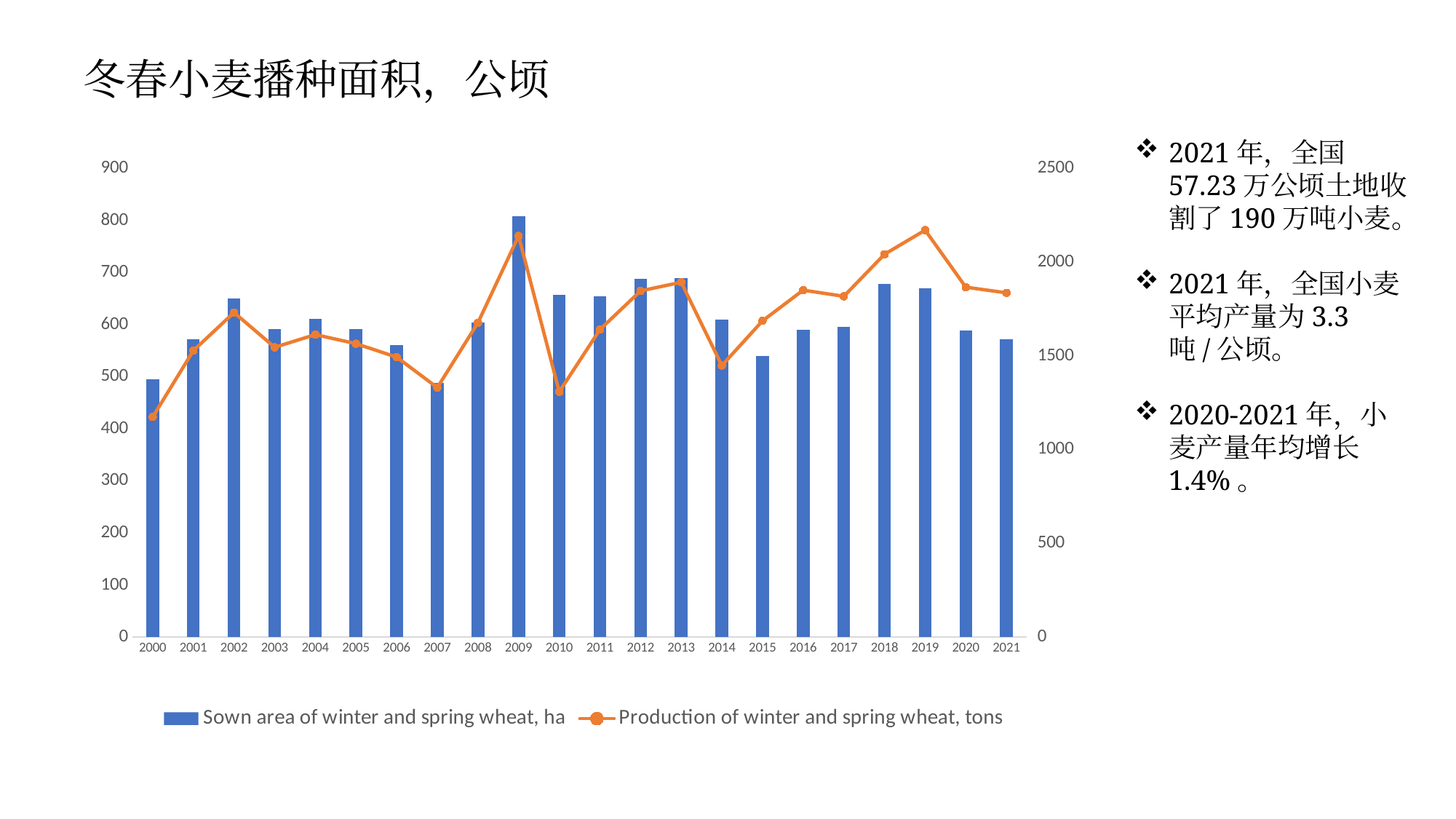
Which year has the larger sown area bar, 2015 or 2018? 2018 Which year has the highest bar for sown area of winter and spring wheat? 2009 How many series does the chart legend list? 2 Is the production value for 2010 greater or less than 1500 on the right axis? less Is the production value for 2009 greater or less than 2000 on the right axis? greater Is the sown area bar for 2015 greater or less than 600? less Which year has the lowest point on the production of winter and spring wheat line? 2000 What is the title of the chart on the slide? 冬春小麦播种面积，公顷 What kind of chart is shown on the slide? A combined bar and line chart Does the production line rise or fall from 2014 to 2019? rise How many years are shown along the x axis of the chart? 22